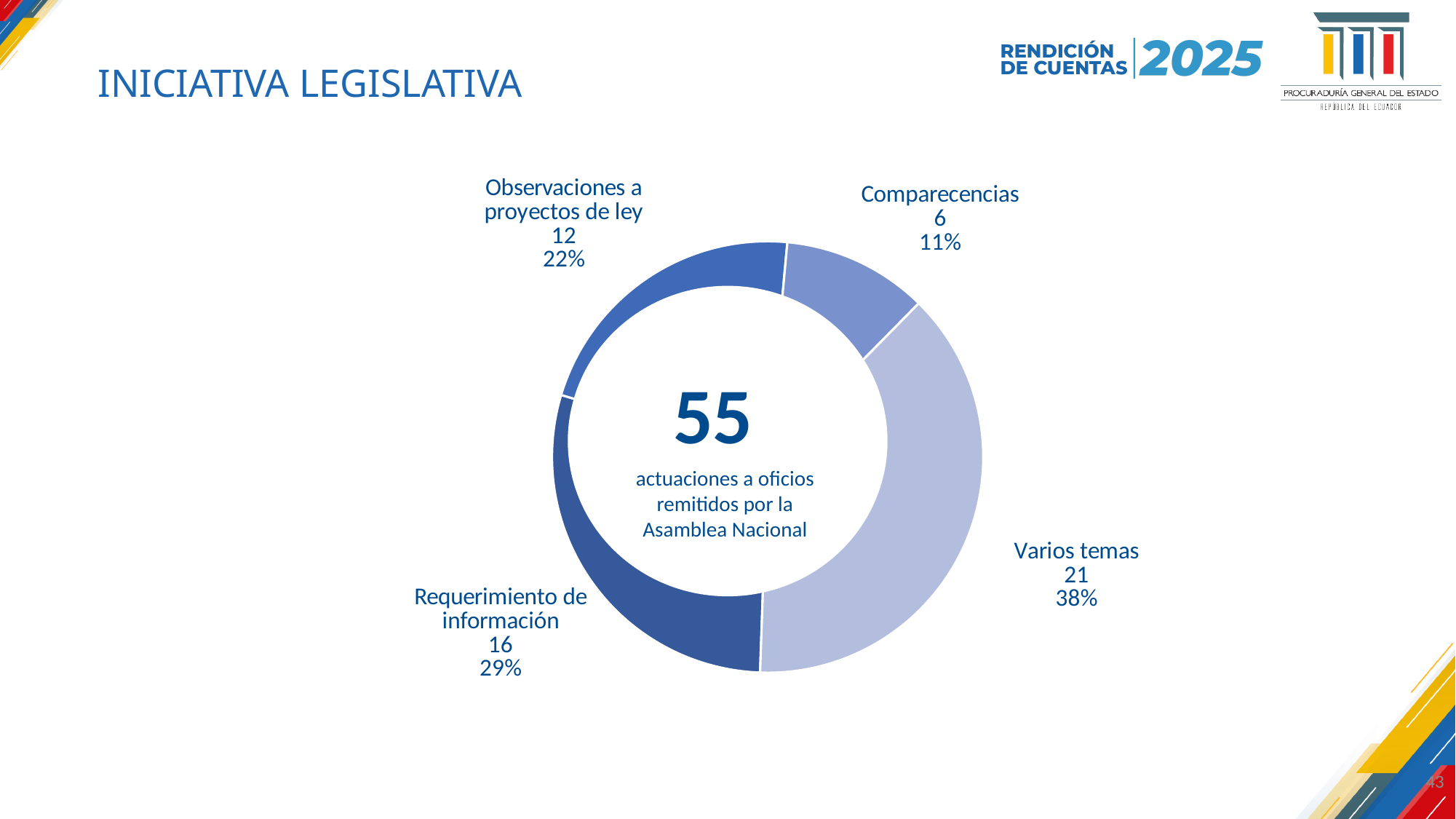
What is the difference between the values for Varios temas and Requerimiento de información? 5 What is the title of the slide? INICIATIVA LEGISLATIVA How many actuaciones are recorded for Varios temas? 21 How many actuaciones are recorded for Requerimiento de información? 16 What total number is shown in the centre of the chart? 55 What percentage share does Comparecencias have? 11% Which category has the lowest number of actuaciones? Comparecencias Which category has the highest number of actuaciones? Varios temas How many categories does the chart show? 4 What percentage share does Observaciones a proyectos de ley have? 22% What kind of chart is shown on the slide? Doughnut chart Which is larger, Observaciones a proyectos de ley or Comparecencias? Observaciones a proyectos de ley